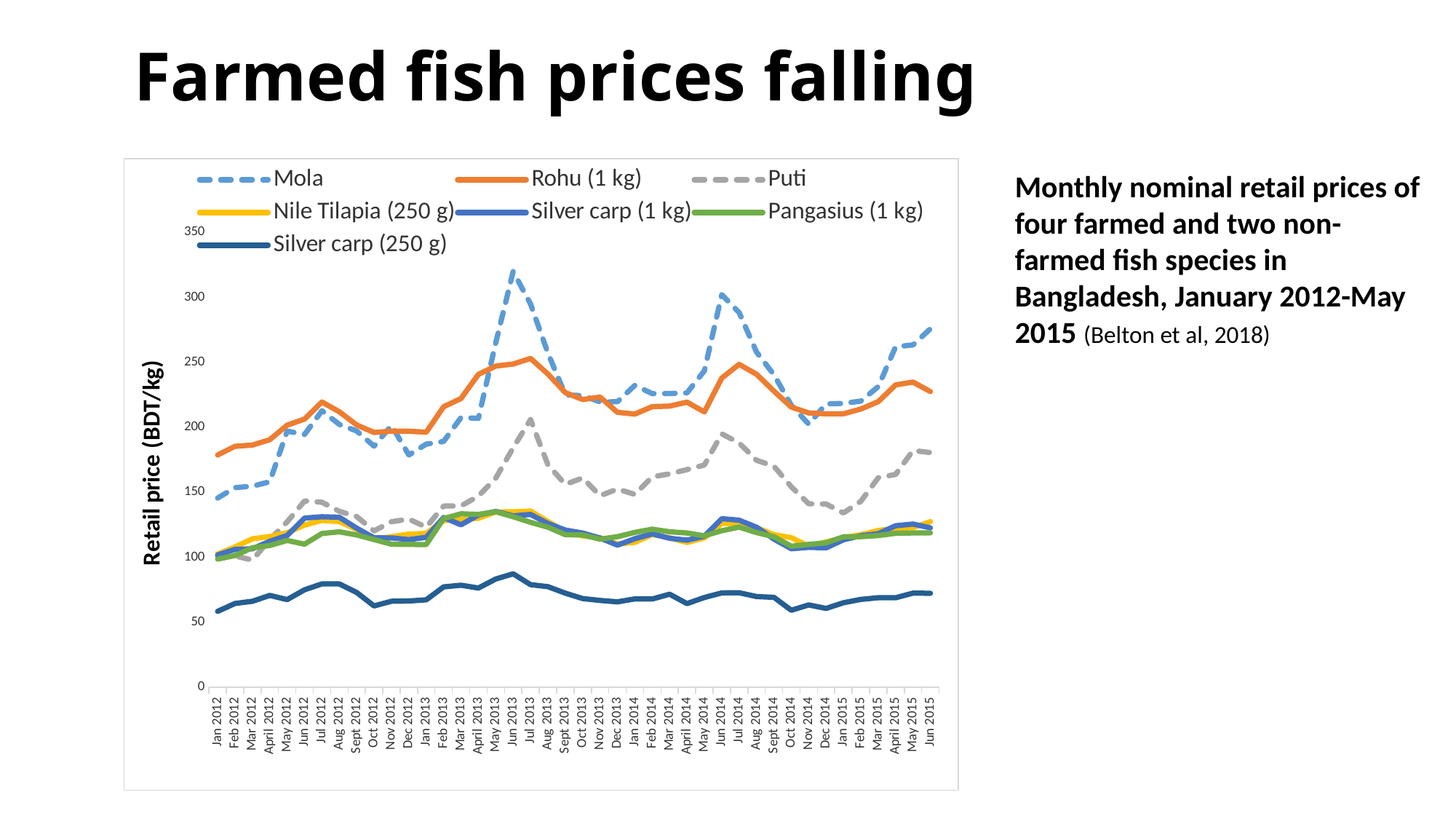
How many series does the chart's legend list? 7 In Jun 2013, which is higher: Mola or Rohu (1 kg)? Mola Is the value for Rohu (1 kg) in Jan 2012 greater or less than 200? less What type of chart is shown on the slide? Line chart Is the value for Mola in Jun 2013 greater or less than 300? greater Is the value for Puti in Jan 2015 greater or less than 150? less In Jan 2012, which is lower: Silver carp (250 g) or Pangasius (1 kg)? Silver carp (250 g) Which series has the lowest values throughout the chart? Silver carp (250 g) Does the value for Rohu (1 kg) rise or fall from Jul 2013 to Dec 2013? Fall Which series reaches the highest value anywhere on the chart? Mola What is the label of the vertical axis of the chart? Retail price (BDT/kg)